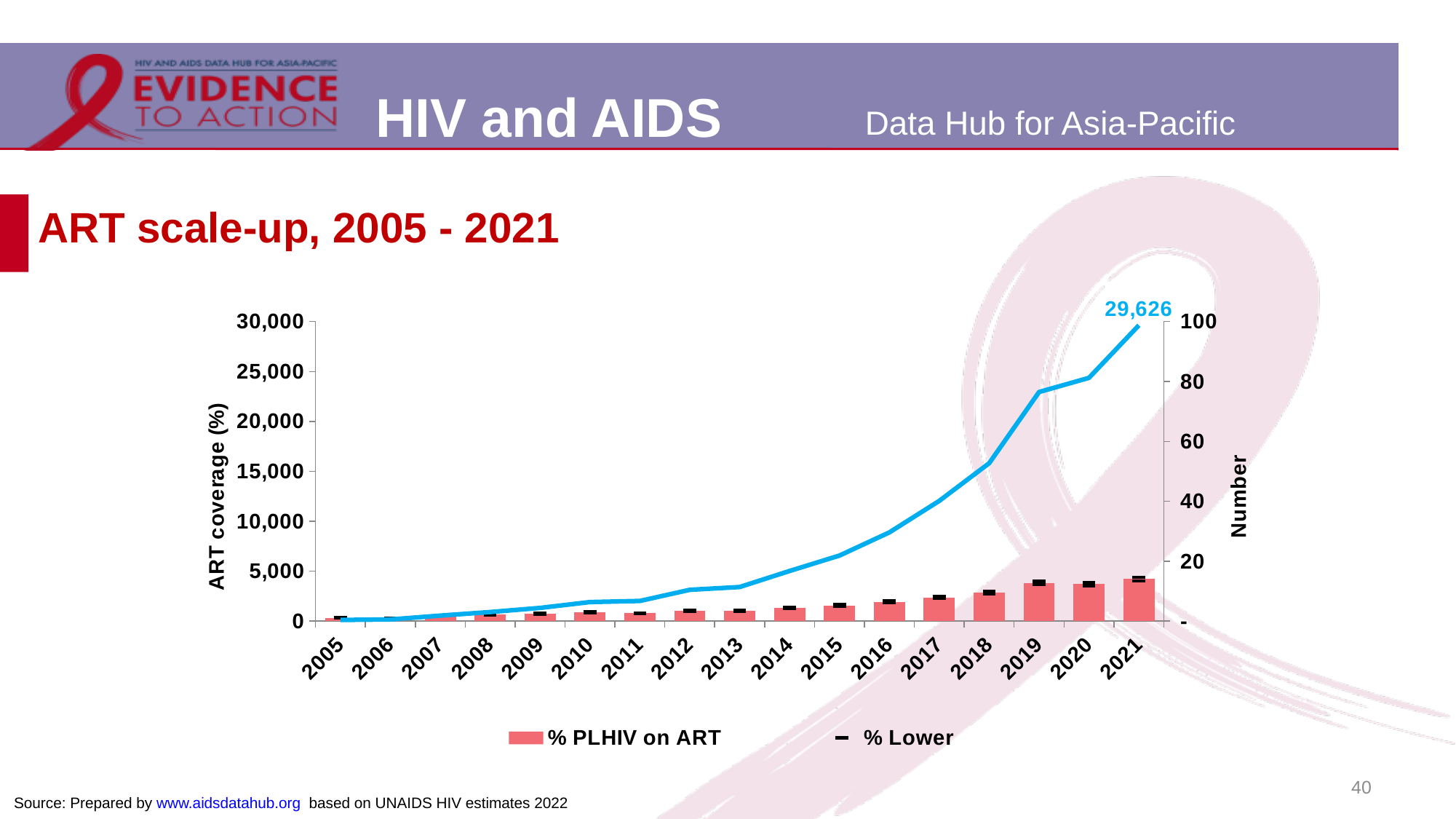
Is the value of the blue line in 2013 greater or less than 5,000? less Which is larger, the blue line value in 2019 or in 2015? 2019 Does the blue line rise or fall from 2005 to 2021? Rises How many years are shown along the x axis of the chart? 17 What are the two entries in the chart's legend? % PLHIV on ART and % Lower What kind of chart is shown on the slide? Combination bar and line chart What value is printed as the data label on the line at 2021? 29,626 In which year is the blue line at its highest? 2021 Is the value of the blue line in 2016 greater or less than 10,000? less Is the value of the blue line in 2019 greater or less than 20,000? greater What is the title of the chart on the slide? ART scale-up, 2005 - 2021 How many series does the chart's legend list? 2